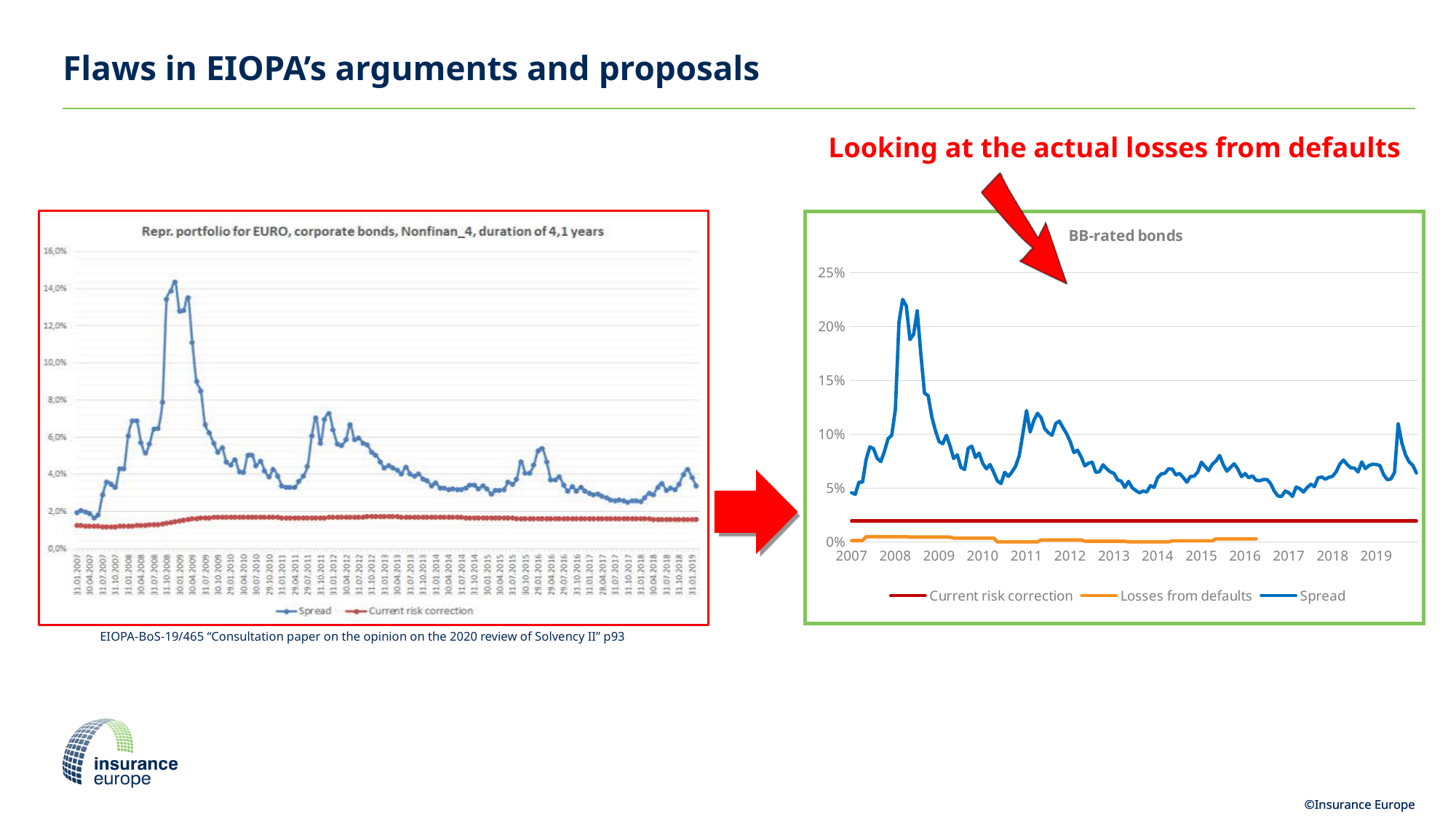
How many series does the legend of the 'BB-rated bonds' chart list? 3 In the 'BB-rated bonds' chart, is the Losses from defaults series greater or less than 5% throughout? less In the left chart ('Repr. portfolio for EURO, corporate bonds, Nonfinan_4, duration of 4,1 years'), is the peak of the Spread series greater or less than 12,0%? greater What kind of chart is the 'BB-rated bonds' chart on the right? line chart In the 'BB-rated bonds' chart, which series is larger: Current risk correction or Losses from defaults? Current risk correction In the 'BB-rated bonds' chart, is the peak value of the Spread series in 2008 greater or less than 20%? greater How many series does the legend of the left chart ('Repr. portfolio for EURO, corporate bonds, Nonfinan_4, duration of 4,1 years') list? 2 In the 'BB-rated bonds' chart, which series is larger in 2008: Spread or Current risk correction? Spread What is the title of the chart on the right of the slide? BB-rated bonds In the 'BB-rated bonds' chart, in which year does the Spread series reach its highest value? 2008